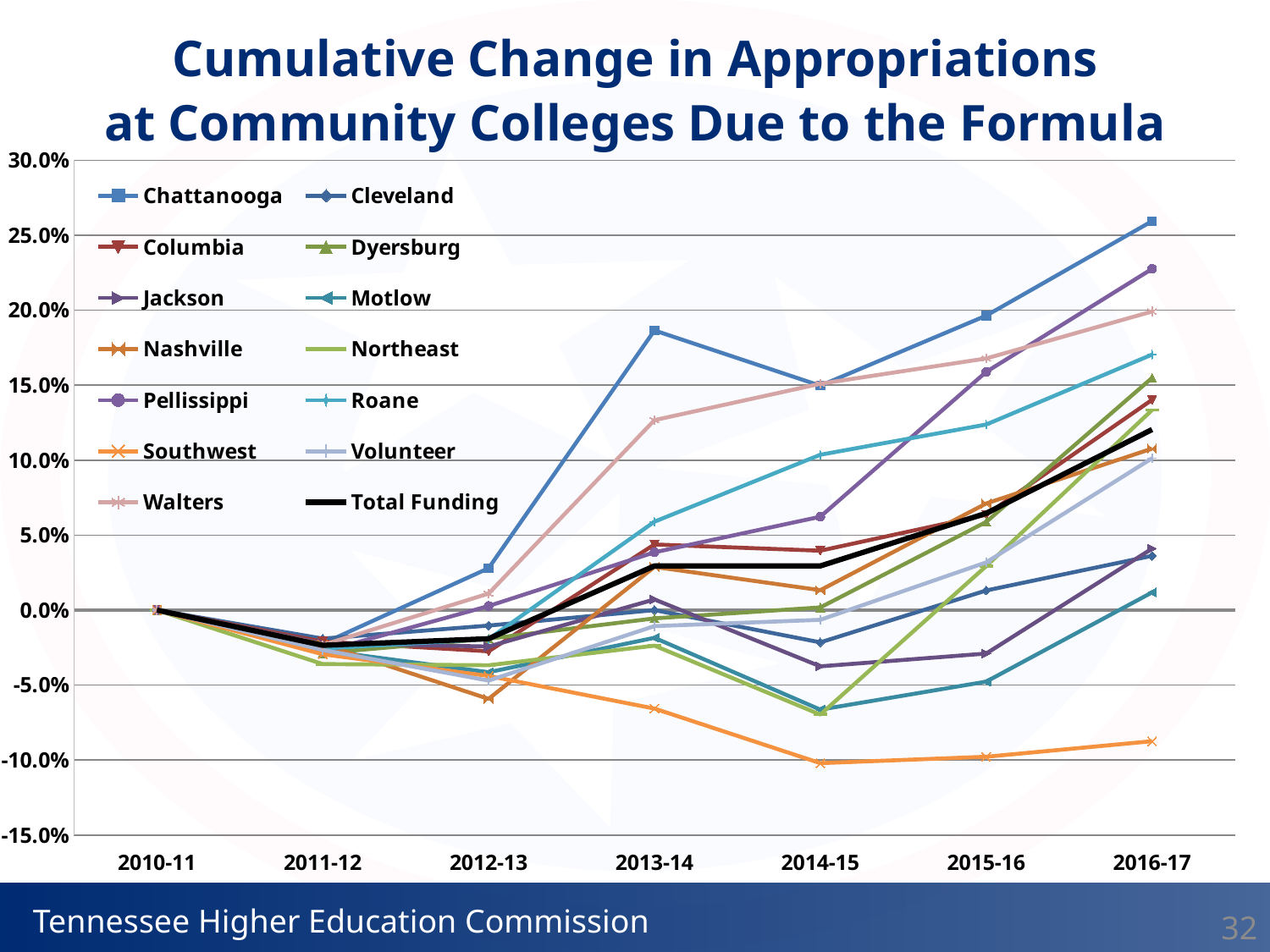
Is the value for Chattanooga in 2013-14 greater or less than 15.0%? greater How many series does the legend list? 14 Which series has the highest value in 2016-17? Chattanooga Is the value for Southwest in 2016-17 greater or less than -10.0%? greater In 2016-17, which is larger: Walters or Roane? Walters Is the value for Chattanooga in 2016-17 greater or less than 25.0%? greater What is the value for Total Funding in 2010-11? 0.0% How many academic years are shown along the x axis? 7 Which series has the lowest value in 2016-17? Southwest What kind of chart is shown on the slide? line chart Does the Southwest line rise or fall from 2010-11 to 2014-15? fall